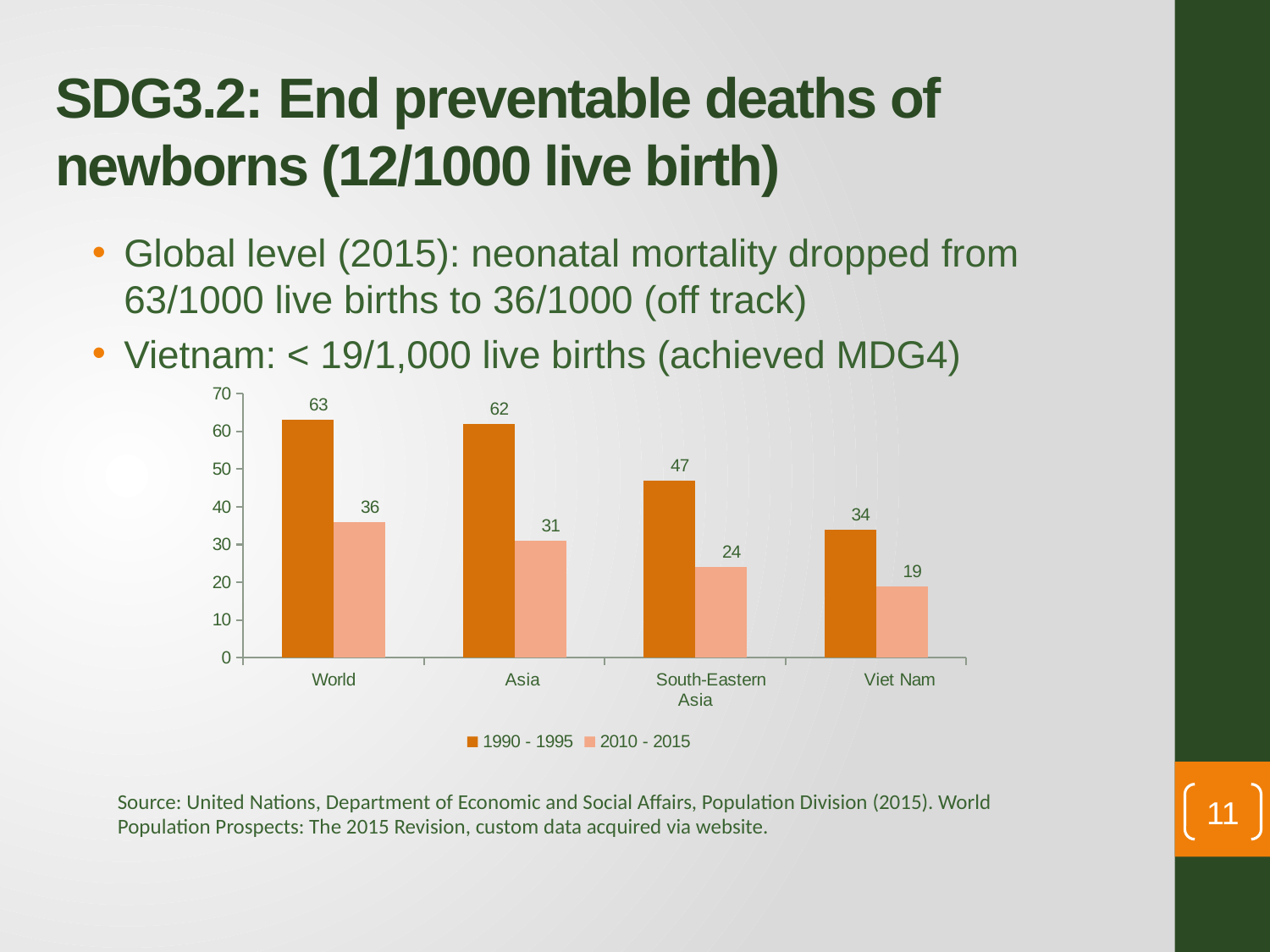
What is the difference between the 1990 - 1995 and 2010 - 2015 values for Asia? 31 What are the two series named in the legend? 1990 - 1995 and 2010 - 2015 What kind of chart is shown on the slide? Bar chart How many categories are shown on the x axis? 4 How many series does the legend list? 2 Which category has the highest value in the 1990 - 1995 series? World What is the value for Viet Nam in the 2010 - 2015 series? 19 Which category has the lowest value in the 2010 - 2015 series? Viet Nam What is the value for South-Eastern Asia in the 2010 - 2015 series? 24 What is the value for World in the 1990 - 1995 series? 63 Do the 1990 - 1995 values rise or fall from World to Viet Nam along the x axis? Fall Which is larger: the 2010 - 2015 value for World or the 1990 - 1995 value for Viet Nam? 2010 - 2015 value for World